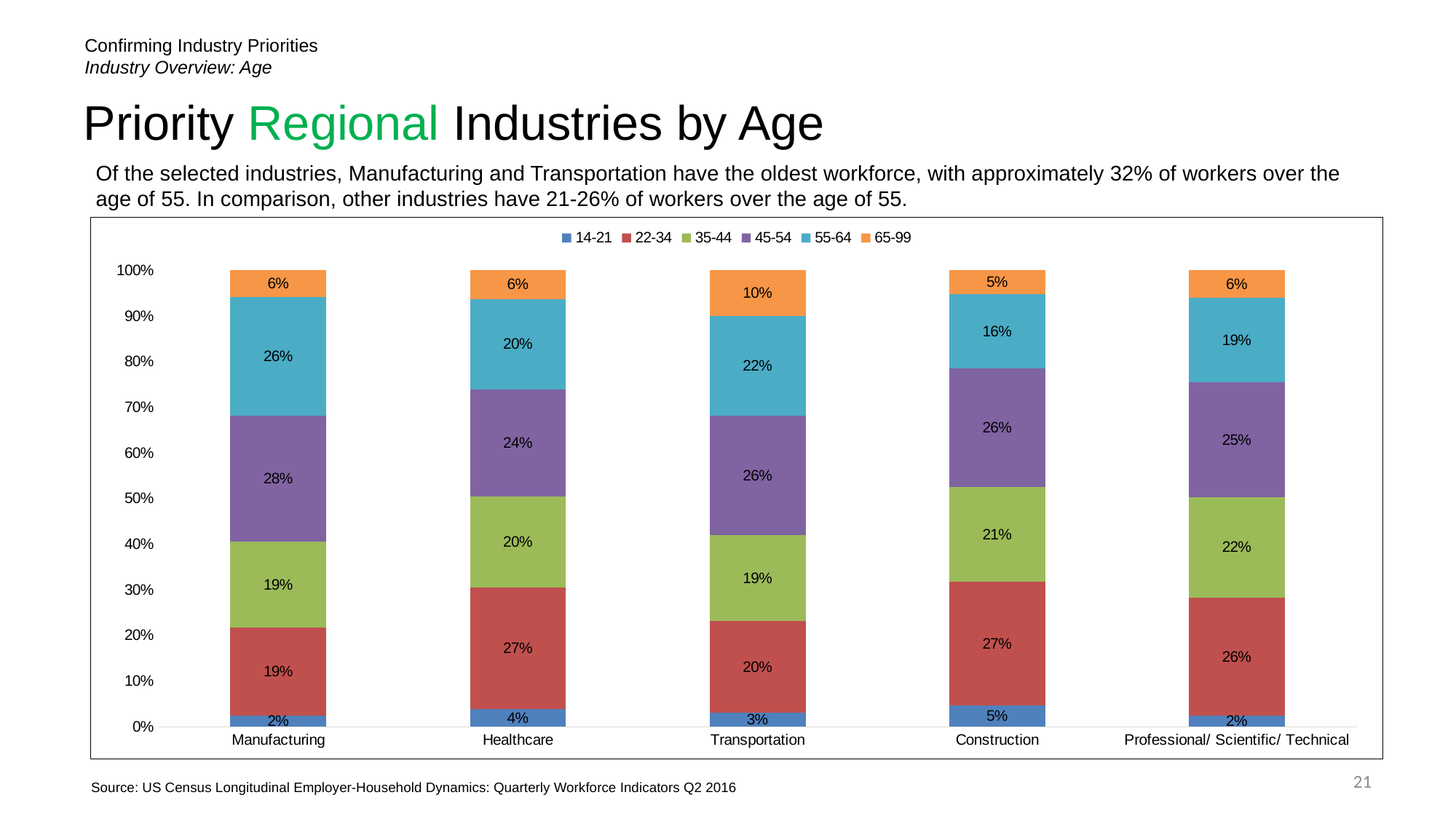
Which is larger: the 22-34 share in Healthcare or the 22-34 share in Transportation? Healthcare How many industries are shown on the x axis? 5 What percentage of the Manufacturing workforce is aged 45-54? 28% Which industry has the highest share of workers aged 65-99? Transportation How many age groups does the legend list? 6 What kind of chart is shown on the slide? Stacked bar chart What is the difference between the 55-64 share in Manufacturing and in Construction? 10% Which industry has the lowest share of workers aged 55-64? Construction What percentage of the Construction workforce is aged 14-21? 5% What percentage of the Healthcare workforce is aged 22-34? 27% What percentage of the Transportation workforce is aged 65-99? 10% What colour represents the 65-99 age group in the chart? Orange